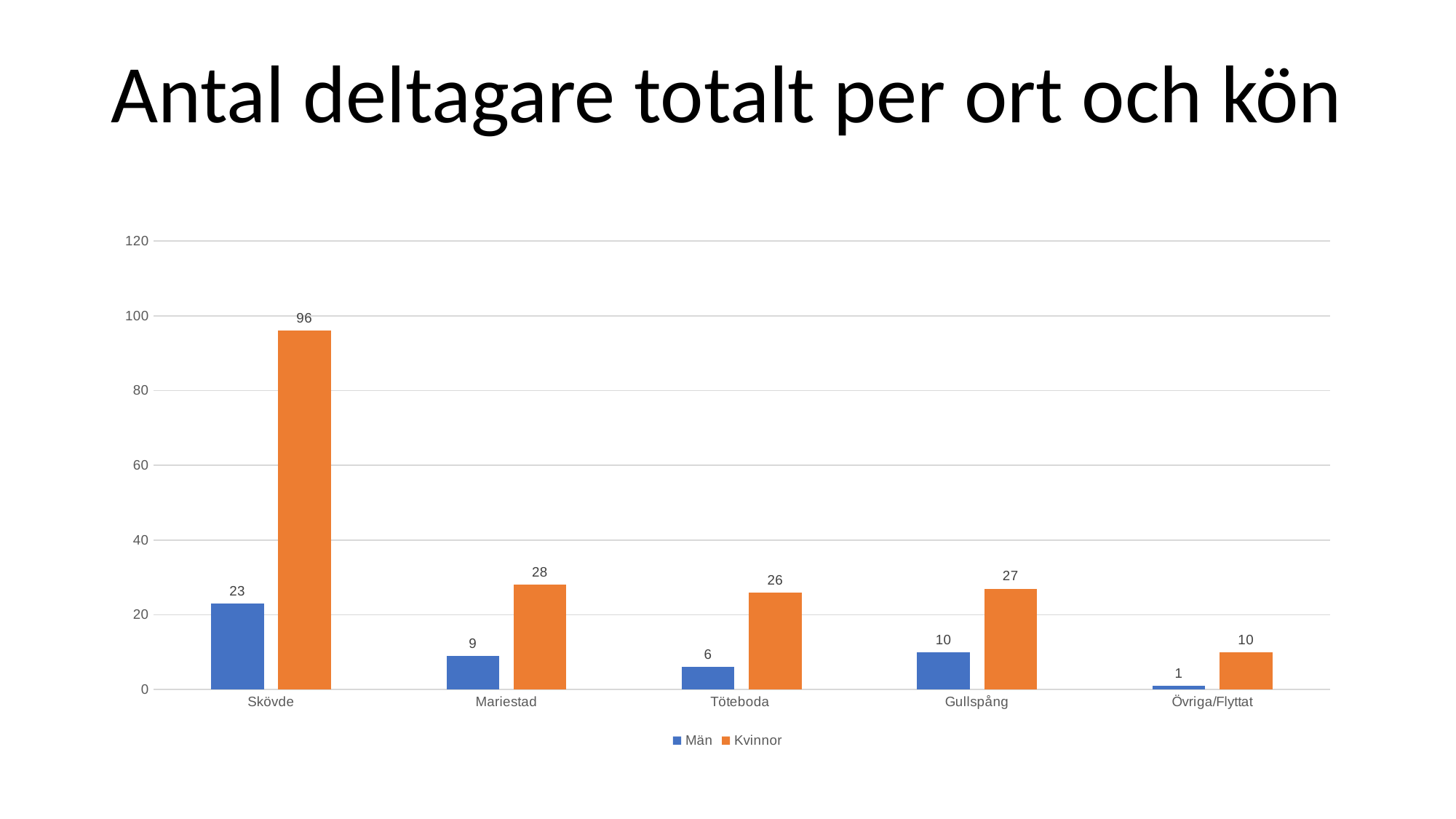
Which is larger: Män in Gullspång or Män in Mariestad? Män in Gullspång How many series does the legend list? 2 What is the title of the chart? Antal deltagare totalt per ort och kön Which location has the highest value for Kvinnor? Skövde What is the value for Kvinnor in Skövde? 96 How many locations are shown on the x axis? 5 What is the difference between Kvinnor and Män in Skövde? 73 Which location has the lowest value for Män? Övriga/Flyttat What is the value for Kvinnor in Töteboda? 26 What kind of chart is shown on the slide? Bar chart What is the total of Män and Kvinnor in Gullspång? 37 What is the value for Män in Mariestad? 9